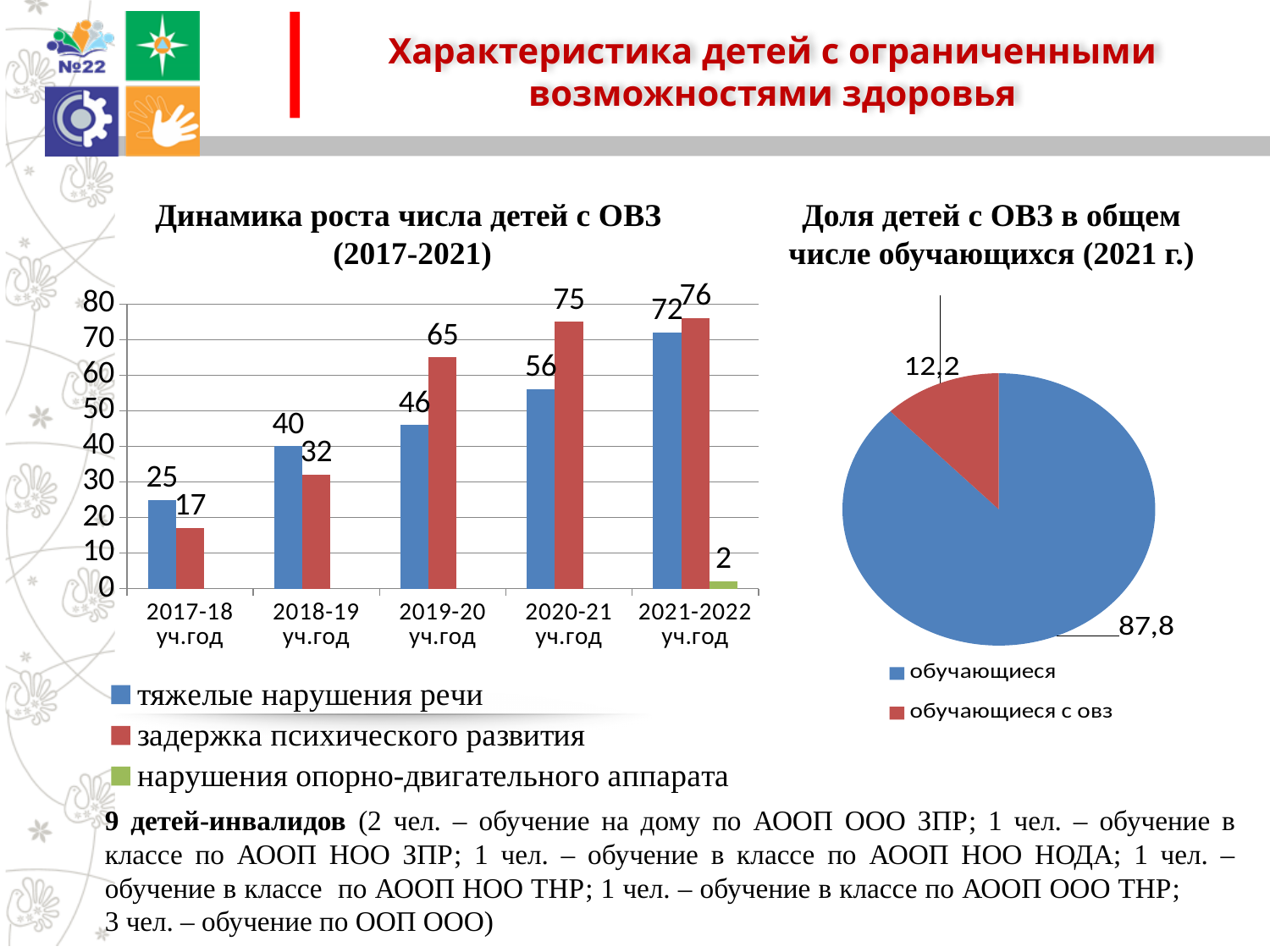
In the chart 'Динамика роста числа детей с ОВЗ (2017-2021)', which series has the larger value in 2018-19 уч.год: 'тяжелые нарушения речи' or 'задержка психического развития'? тяжелые нарушения речи In the pie chart 'Доля детей с ОВЗ в общем числе обучающихся (2021 г.)', what is the value for 'обучающиеся с овз'? 12,2 What type of chart is 'Доля детей с ОВЗ в общем числе обучающихся (2021 г.)'? Pie chart In the chart 'Динамика роста числа детей с ОВЗ (2017-2021)', what is the difference between 'задержка психического развития' and 'тяжелые нарушения речи' in 2019-20 уч.год? 19 In the chart 'Динамика роста числа детей с ОВЗ (2017-2021)', what is the value for 'тяжелые нарушения речи' in 2019-20 уч.год? 46 In the chart 'Динамика роста числа детей с ОВЗ (2017-2021)', in which school year is the value for 'тяжелые нарушения речи' the lowest? 2017-18 уч.год In the chart 'Динамика роста числа детей с ОВЗ (2017-2021)', in which school year is the value for 'задержка психического развития' the highest? 2021-2022 уч.год How many series does the legend of the chart 'Динамика роста числа детей с ОВЗ (2017-2021)' list? 3 In the chart 'Динамика роста числа детей с ОВЗ (2017-2021)', what is the value for 'задержка психического развития' in 2020-21 уч.год? 75 In the chart 'Динамика роста числа детей с ОВЗ (2017-2021)', what is the value for 'нарушения опорно-двигательного аппарата' in 2021-2022 уч.год? 2 In the chart 'Динамика роста числа детей с ОВЗ (2017-2021)', how does the value for 'тяжелые нарушения речи' change from 2017-18 to 2021-2022? It rises How many school years are shown on the x axis of the chart 'Динамика роста числа детей с ОВЗ (2017-2021)'? 5